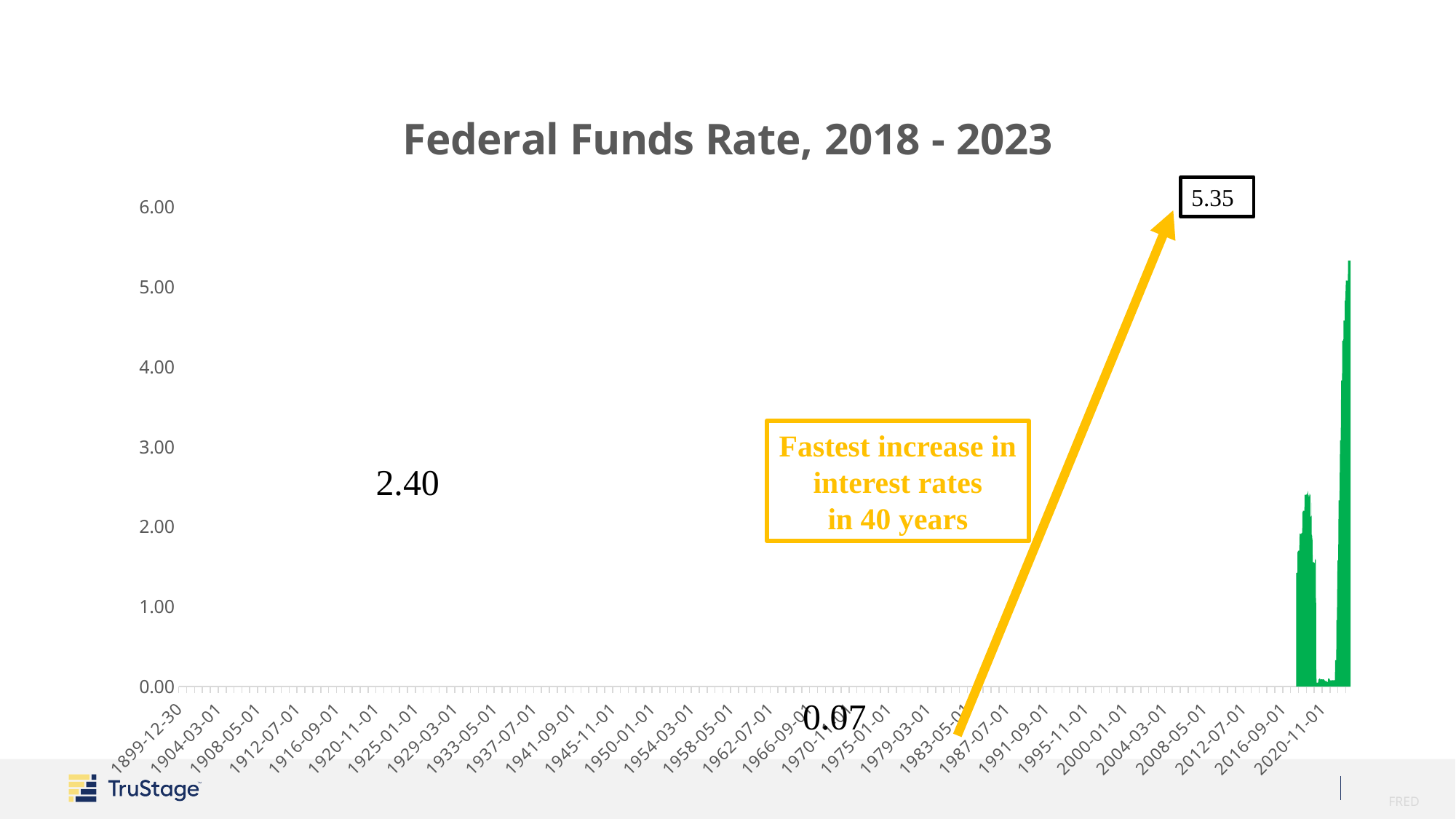
Is the earlier peak of the Federal Funds Rate greater or less than 3.00? less What is the title of the chart? Federal Funds Rate, 2018 - 2023 What is the difference between the two labelled peaks, 5.35 and 2.40? 2.95 Is the final peak of the Federal Funds Rate greater or less than 5.00? greater What value is labelled for the earlier, smaller peak in the Federal Funds Rate? 2.40 Does the Federal Funds Rate rise or fall at the right-hand end of the chart? rise What does the yellow callout box on the chart say? Fastest increase in interest rates in 40 years What is the lowest value labelled on the chart? 0.07 What is the difference between the labelled peak of 5.35 and the labelled low of 0.07? 5.28 What is the highest value labelled on the chart? 5.35 What is the highest tick value shown on the y-axis? 6.00 Which labelled peak is larger, 5.35 or 2.40? 5.35